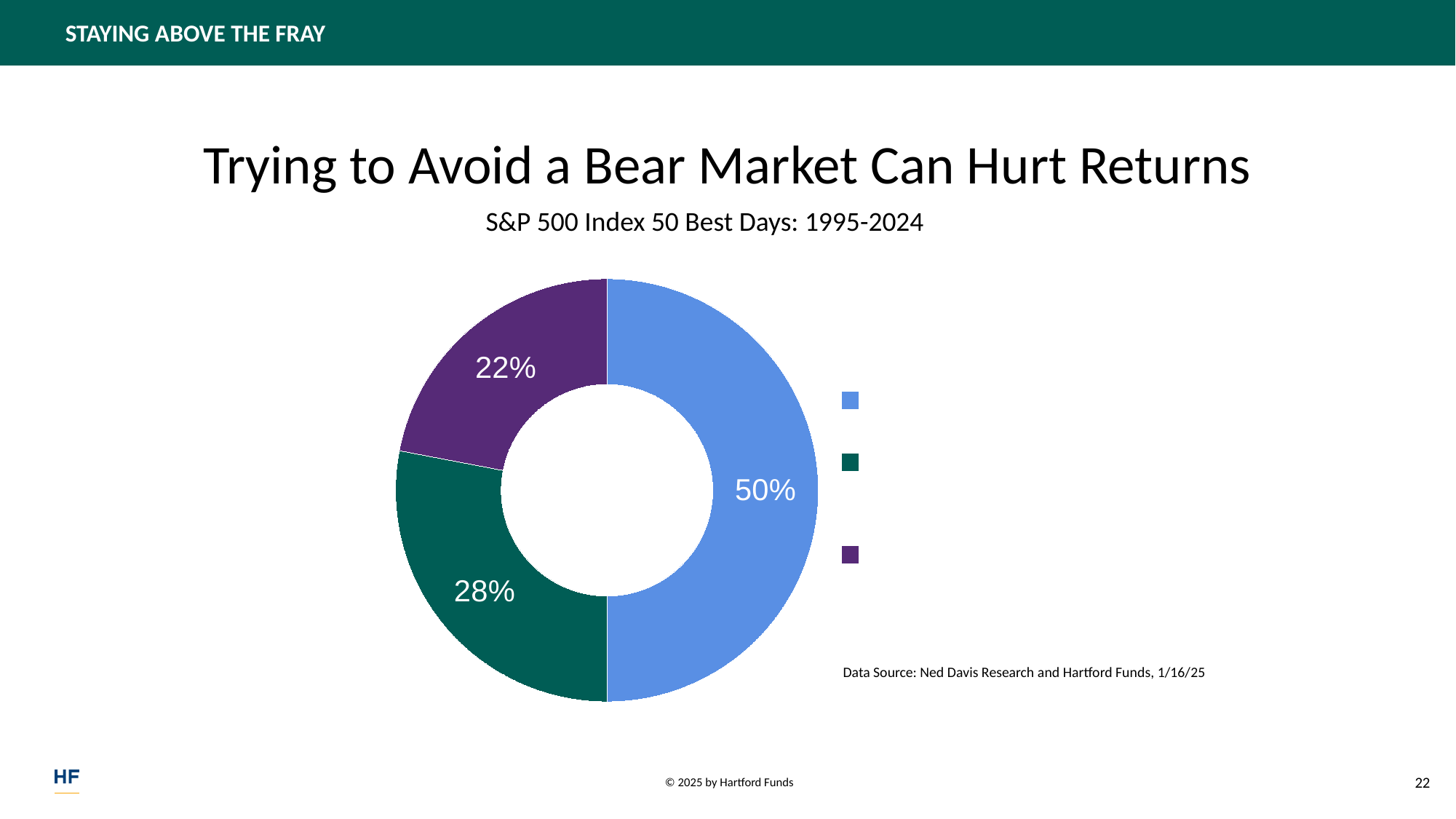
What percentage is shown on the green slice of the donut chart? 28% What is the subtitle of the chart? S&P 500 Index 50 Best Days: 1995-2024 What is the combined share of the green and purple slices? 50% What is the difference between the green slice and the purple slice? 6% How many slices does the donut chart have? 3 Which is larger, the green slice or the purple slice? Green slice Which colour slice has the largest share of the donut chart? Blue What percentage is shown on the blue slice of the donut chart? 50% What is the difference between the blue slice and the green slice? 22% Which colour slice has the smallest share of the donut chart? Purple What percentage is shown on the purple slice of the donut chart? 22% What kind of chart is shown on the slide? Pie chart (donut)